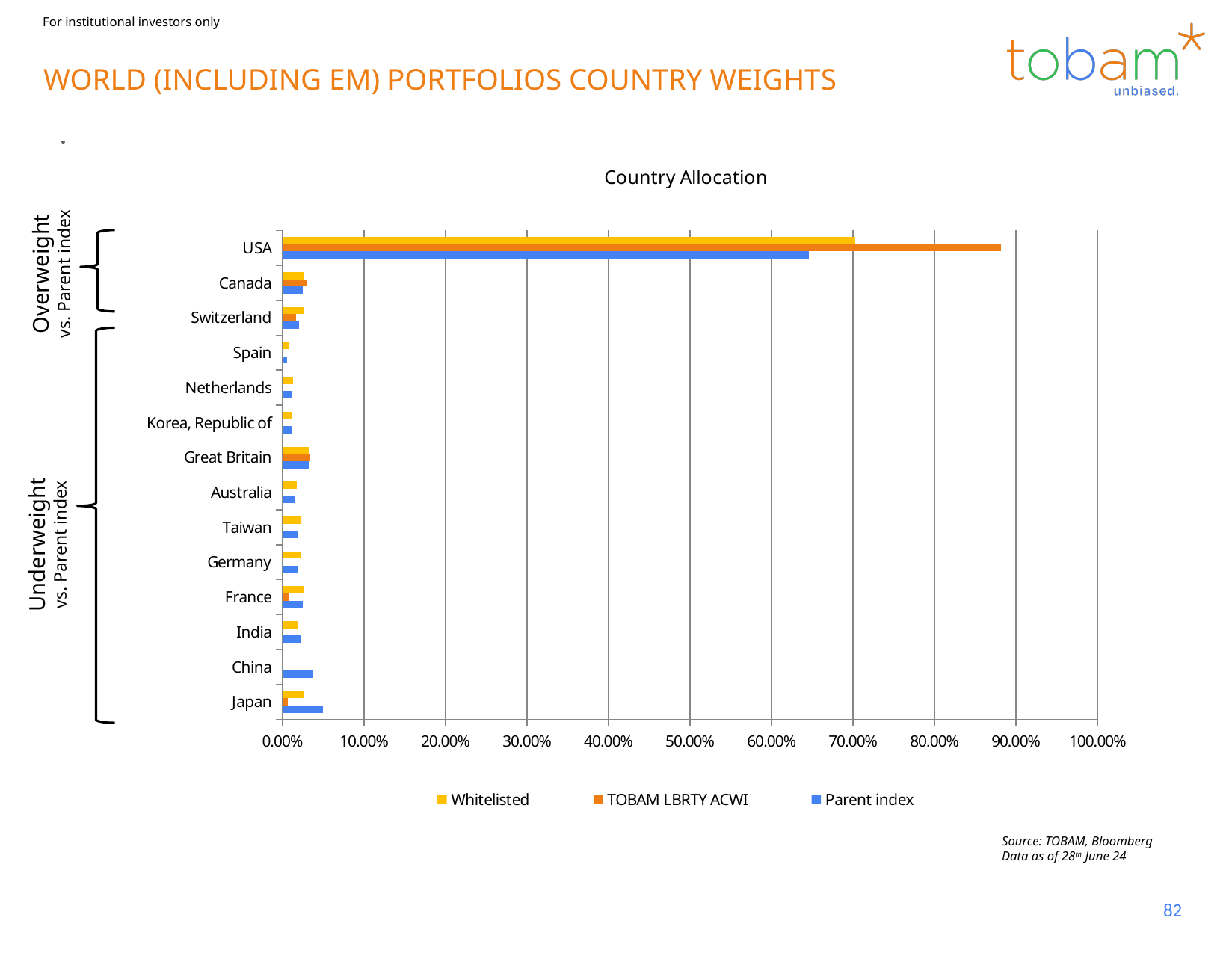
For Japan, which is larger: the Whitelisted value or the Parent index value? Parent index Which country has the highest TOBAM LBRTY ACWI weight? USA How many countries are shown on the chart? 14 Which country has the highest Parent index weight? USA What is the title of the chart? Country Allocation How many series does the legend list? 3 Is the Whitelisted value for USA greater or less than 60.00%? greater Is the Parent index value for USA greater or less than 70.00%? less Which series is shown in blue in the legend? Parent index What kind of chart is shown on the slide? Bar chart For USA, which is larger: the TOBAM LBRTY ACWI value or the Parent index value? TOBAM LBRTY ACWI Is the TOBAM LBRTY ACWI value for USA greater or less than 80.00%? greater